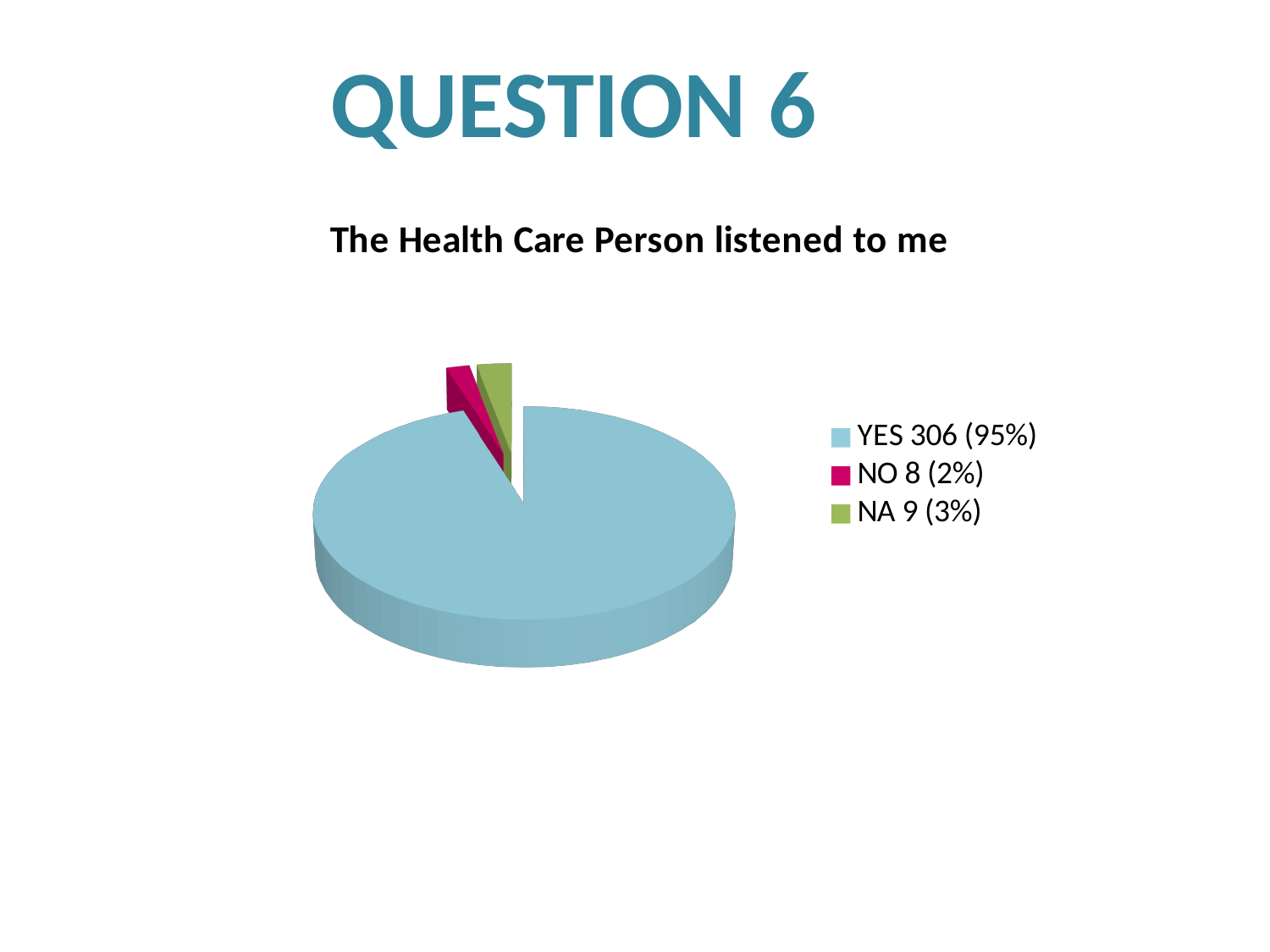
What kind of chart is shown on the slide? Pie chart Which category has the smallest share of the pie? NO What percentage of responses are NA? 3% What is the total number of responses across all three categories? 323 How many responses are recorded for NO? 8 How many responses are recorded for NA? 9 How many categories does the pie chart show? 3 What is the title of the chart? The Health Care Person listened to me What percentage of responses are YES? 95% How many responses are recorded for YES? 306 What is the difference between the number of YES responses and the number of NO responses? 298 Which category has the largest share of the pie? YES